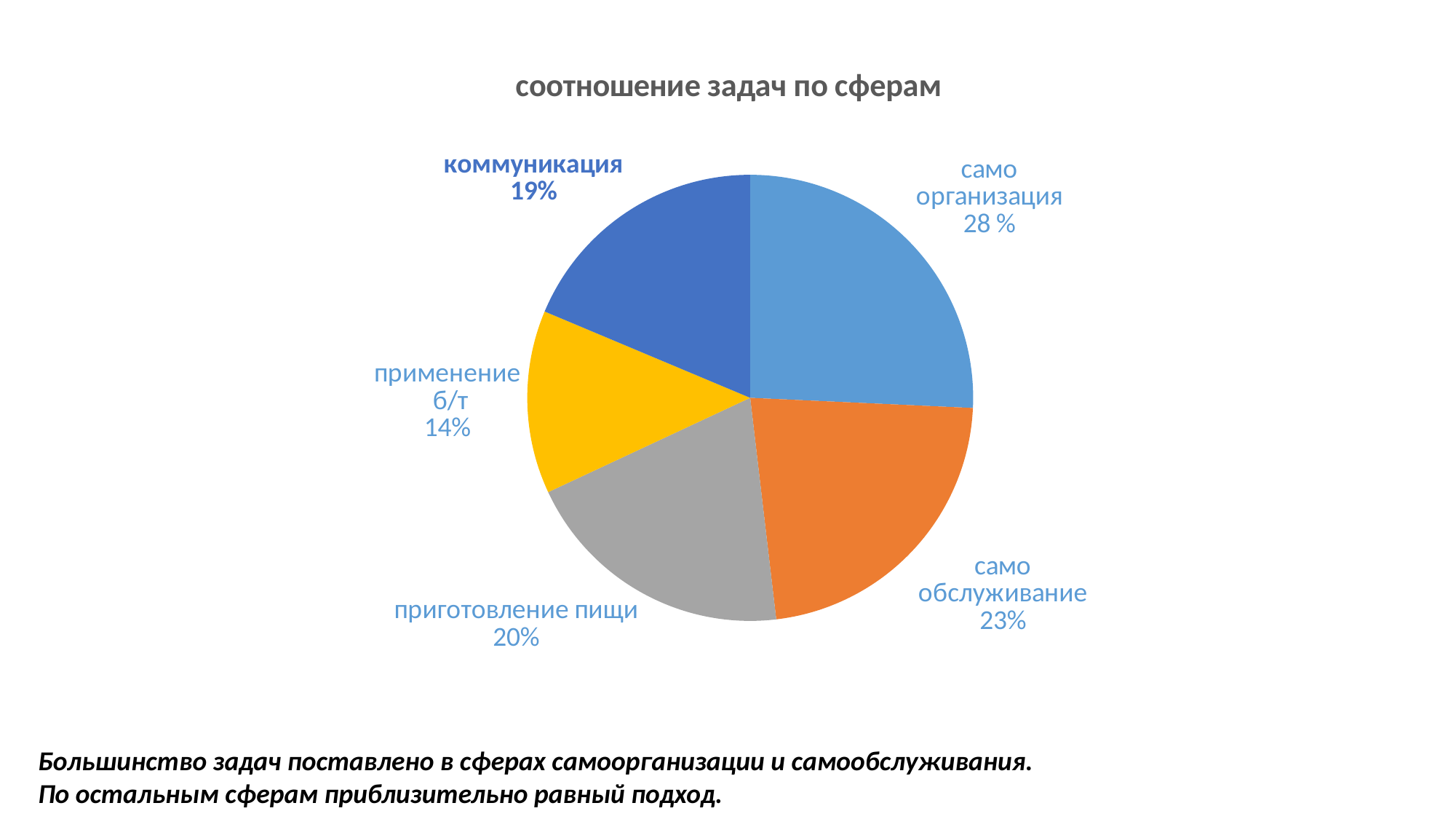
What share of the pie does самоорганизация have? 28 % How many slices does the pie chart have? 5 Which is larger, the share for приготовление пищи or the share for коммуникация? приготовление пищи Which category has the largest slice of the pie? самоорганизация Which category has the smallest slice of the pie? применение б/т What is the title of the chart? соотношение задач по сферам What share of the pie does коммуникация have? 19% What is the difference in percentage points between самоорганизация and применение б/т? 14 What share of the pie does применение б/т have? 14% What share of the pie does приготовление пищи have? 20% What share of the pie does самообслуживание have? 23% What type of chart is shown on the slide? pie chart